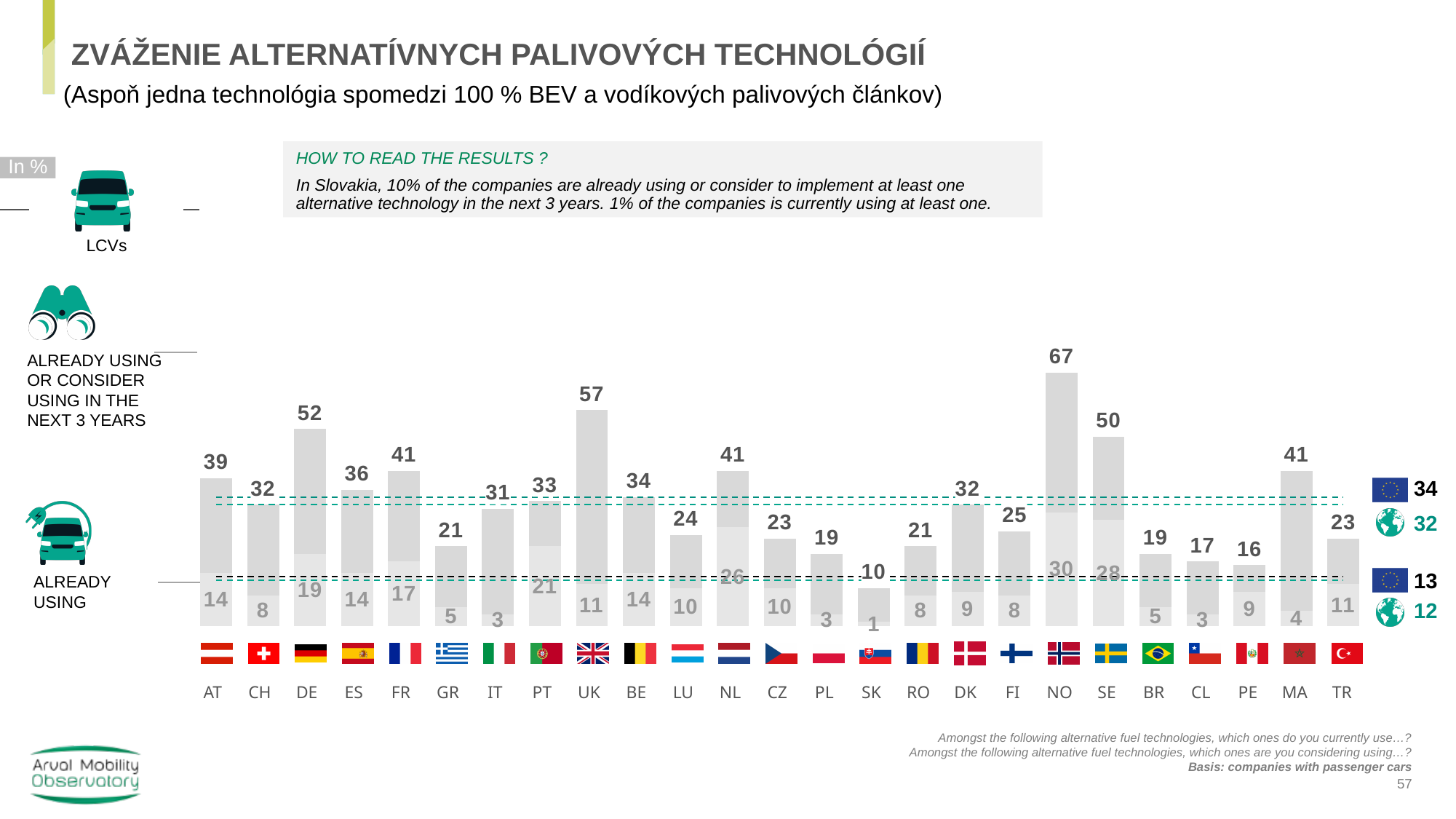
What is the 'already using or consider using in the next 3 years' value for UK? 57 How many countries are shown on the x axis of the chart? 25 Which has a higher 'already using or consider using' value, SE or MA? SE What is the difference between the 'already using or consider using' values for UK and DE? 5 Which country has the highest 'already using or consider using in the next 3 years' value? NO What kind of chart is shown on the slide? bar chart What is the value for NO in the 'already using or consider using in the next 3 years' series? 67 Which country has the lowest 'already using or consider using in the next 3 years' value? SK What is the difference between the 'already using' values for NO and SE? 2 What is the EU average value shown for 'already using'? 13 What is the 'already using' value for SK? 1 What is the 'already using' value for NL? 26